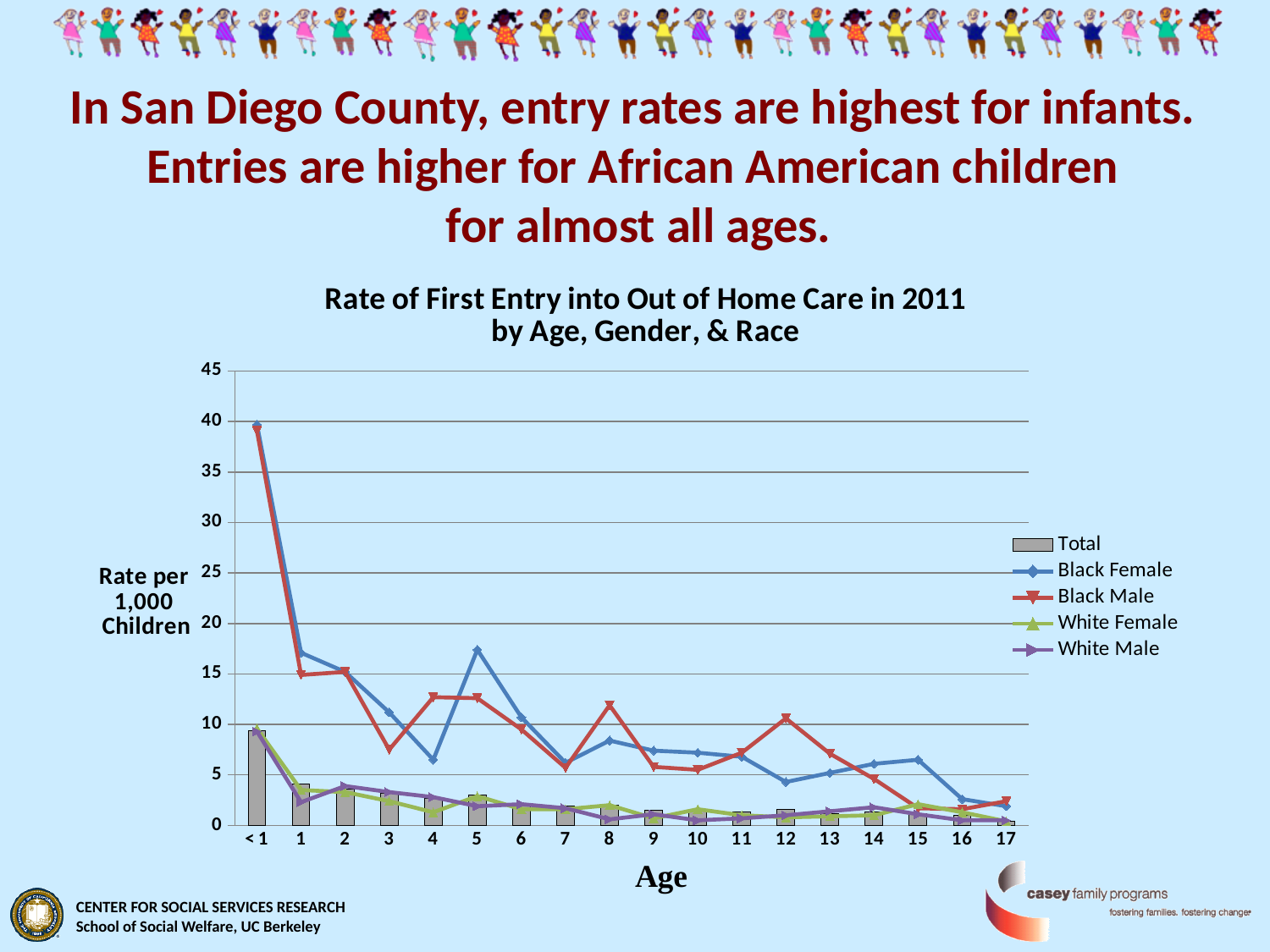
Is the Black Female value for age 17 greater or less than 5? less Is the Black Female value for age < 1 greater or less than 35? greater At which age is the Total rate highest? < 1 How many age categories are shown along the x axis? 18 How many series does the chart legend list? 5 What is the label on the vertical axis of the chart? Rate per 1,000 Children At age 5, which is larger: the Black Female rate or the Black Male rate? Black Female Overall, does the Black Male rate rise or fall from age < 1 to age 17? fall Which series is plotted as bars rather than a line? Total At age 12, which is larger: the Black Male rate or the Black Female rate? Black Male At which age is the Black Female rate highest? < 1 Is the Black Female value for age 5 greater or less than 15? greater